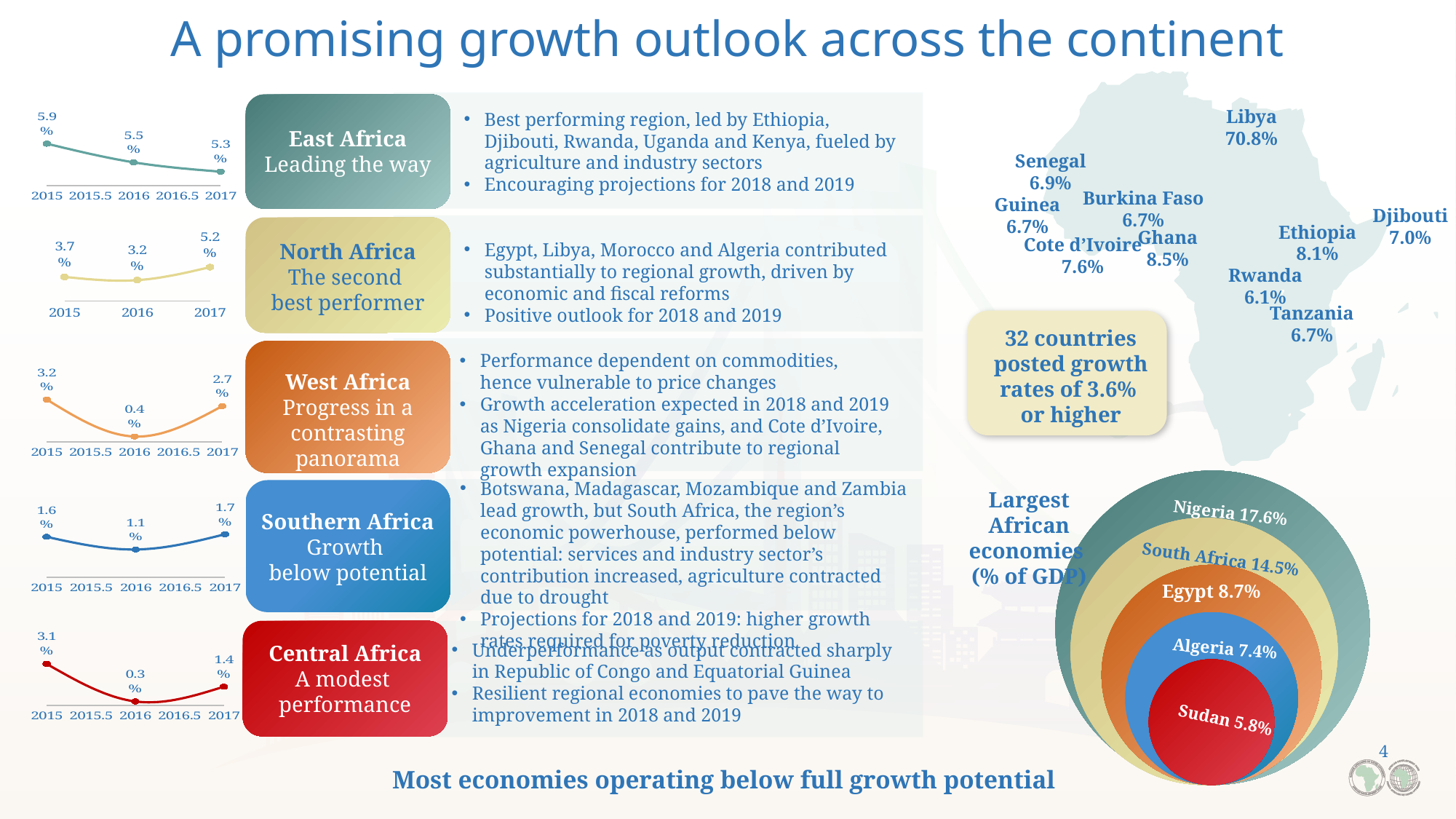
In the line chart next to the North Africa box, which year has the highest value? 2017 In the line chart next to the East Africa box, what is the value for 2017? 5.3% In the line chart next to the Southern Africa box, what is the difference between the 2017 value and the 2016 value? 0.6% In the line chart next to the West Africa box, which year has the lowest value? 2016 How many data points are plotted in the line chart next to the North Africa box? 3 In the line chart next to the Central Africa box, what is the difference between the 2015 value and the 2016 value? 2.8% What kind of chart is shown next to the East Africa box? line chart In the line chart next to the West Africa box, which is larger, the 2015 value or the 2017 value? 2015 In the line chart next to the Central Africa box, what is the value for 2015? 3.1% In the 'Largest African economies (% of GDP)' nested circle chart, what is the value for Nigeria? 17.6% In the line chart next to the East Africa box, do the values rise or fall from 2015 to 2017? fall In the 'Largest African economies (% of GDP)' nested circle chart, which country has the lowest value? Sudan